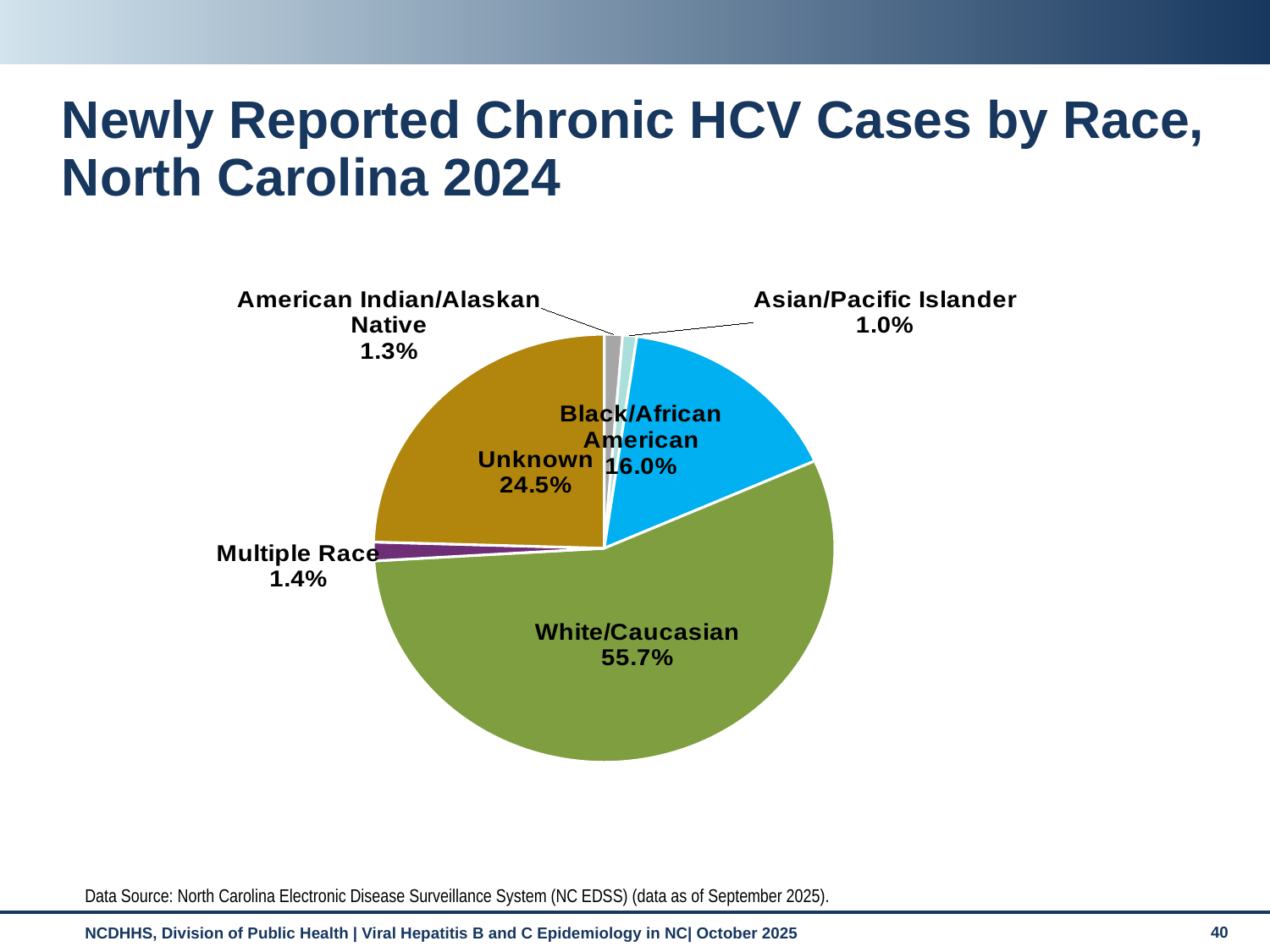
How many race categories are shown in the pie chart? 6 What share of newly reported chronic HCV cases is White/Caucasian? 55.7% What is the difference in percentage points between White/Caucasian and Unknown? 31.2 Which race category has the largest share of cases? White/Caucasian Which race category has the smallest share of cases? Asian/Pacific Islander Which is larger, the share for Multiple Race or the share for Black/African American? Black/African American What is the value for Black/African American? 16.0% What is the value for Asian/Pacific Islander? 1.0% What is the title of the chart on the slide? Newly Reported Chronic HCV Cases by Race, North Carolina 2024 What type of chart is shown on the slide? Pie chart What is the value for American Indian/Alaskan Native? 1.3% What percentage of cases is labelled Unknown? 24.5%